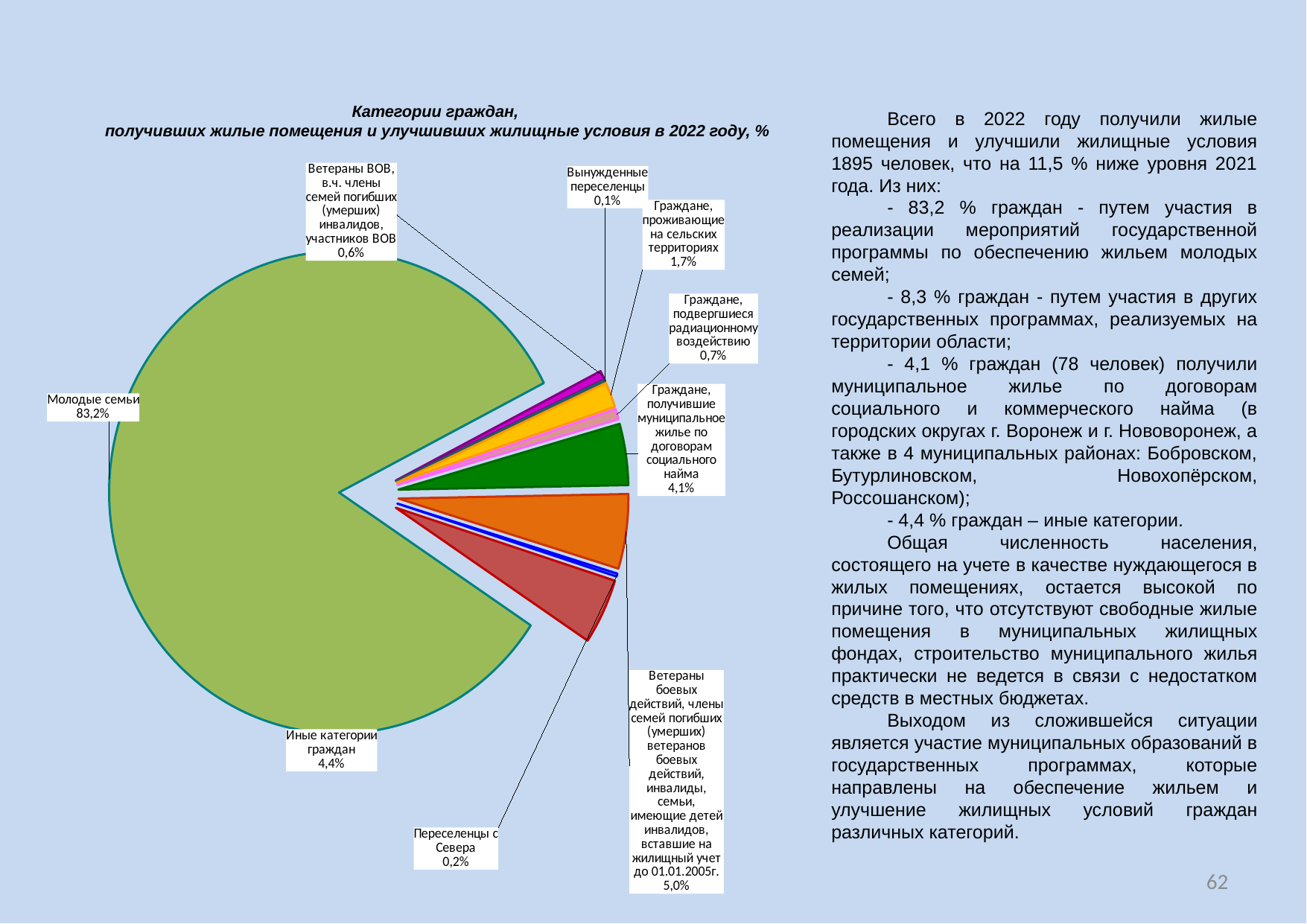
What kind of chart is shown on the slide? pie chart What value is shown for "Граждане, получившие муниципальное жилье по договорам социального найма"? 4,1% What is the difference in percentage points between "Иные категории граждан" and "Граждане, получившие муниципальное жилье по договорам социального найма"? 0,3 What share of the pie is labelled for "Молодые семьи"? 83,2% How many categories are shown in the pie chart? 9 What value is shown for "Граждане, проживающие на сельских территориях"? 1,7% Which is larger: the share for "Граждане, подвергшиеся радиационному воздействию" or for "Ветераны ВОВ, в.ч. члены семей погибших (умерших) инвалидов, участников ВОВ"? Граждане, подвергшиеся радиационному воздействию What value is shown for "Иные категории граждан"? 4,4% What value is shown for "Переселенцы с Севера"? 0,2% Which year does the chart title refer to? 2022 Which category has the smallest share of the pie? Вынужденные переселенцы Which category has the largest share of the pie? Молодые семьи